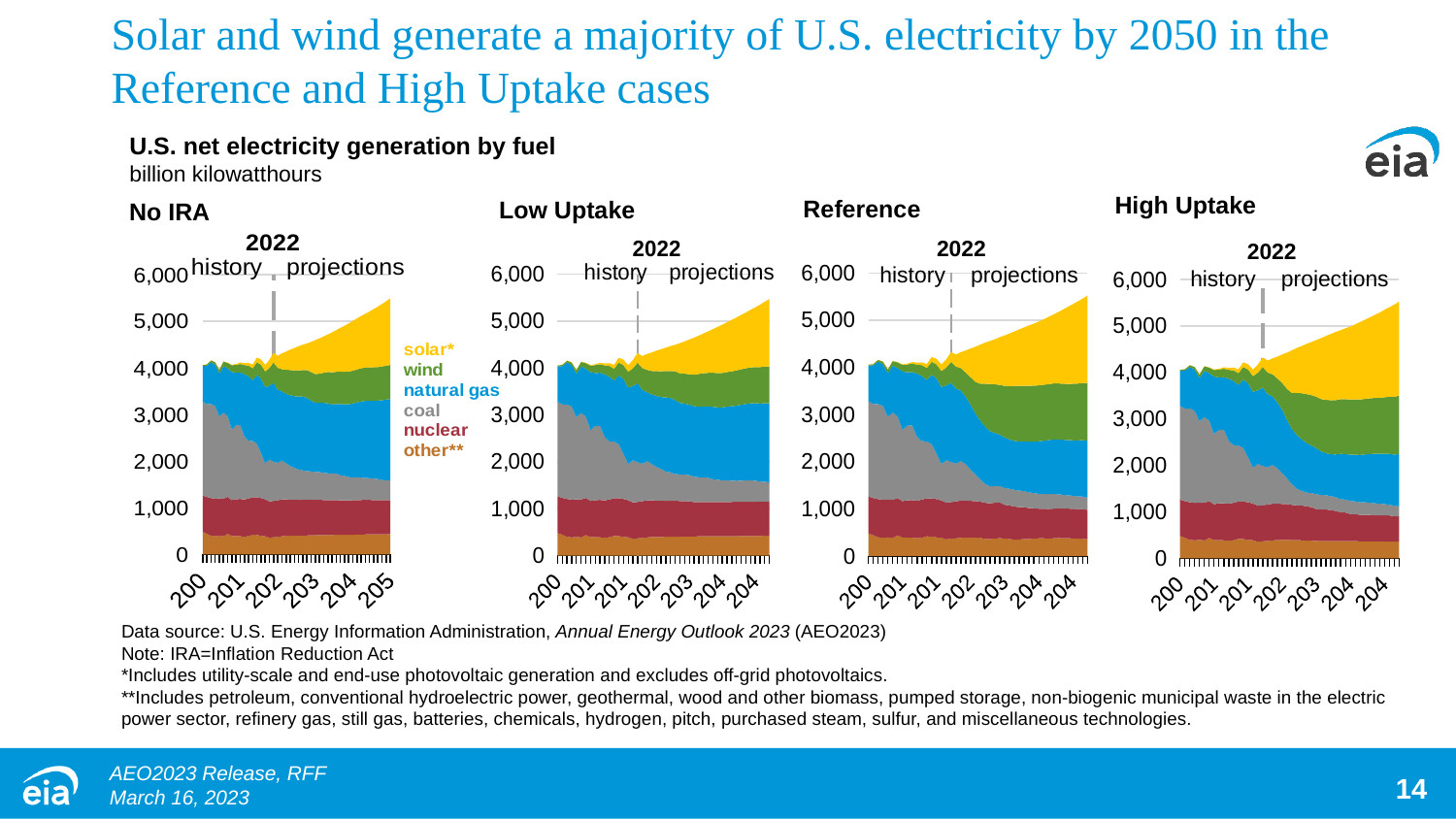
In the No IRA chart, is the total generation at the right end of the projection period greater or less than 5,000? greater What is the title of the chart group on the slide? U.S. net electricity generation by fuel In the No IRA chart, is the total generation at the start of the history period greater or less than 5,000? less In the High Uptake chart, is the total generation at the right end of the projection period greater or less than 6,000? less What year does the dashed vertical line separating history from projections mark? 2022 In the High Uptake chart, does the coal band grow or shrink over the projection period? shrink In the Low Uptake chart, does total generation rise or fall over the projection period? rise How many charts are shown on the slide? 4 How many fuel series does the legend list? 6 In the Reference chart, does the solar band grow or shrink over the projection period? grow What kind of chart is used on this slide? stacked area chart